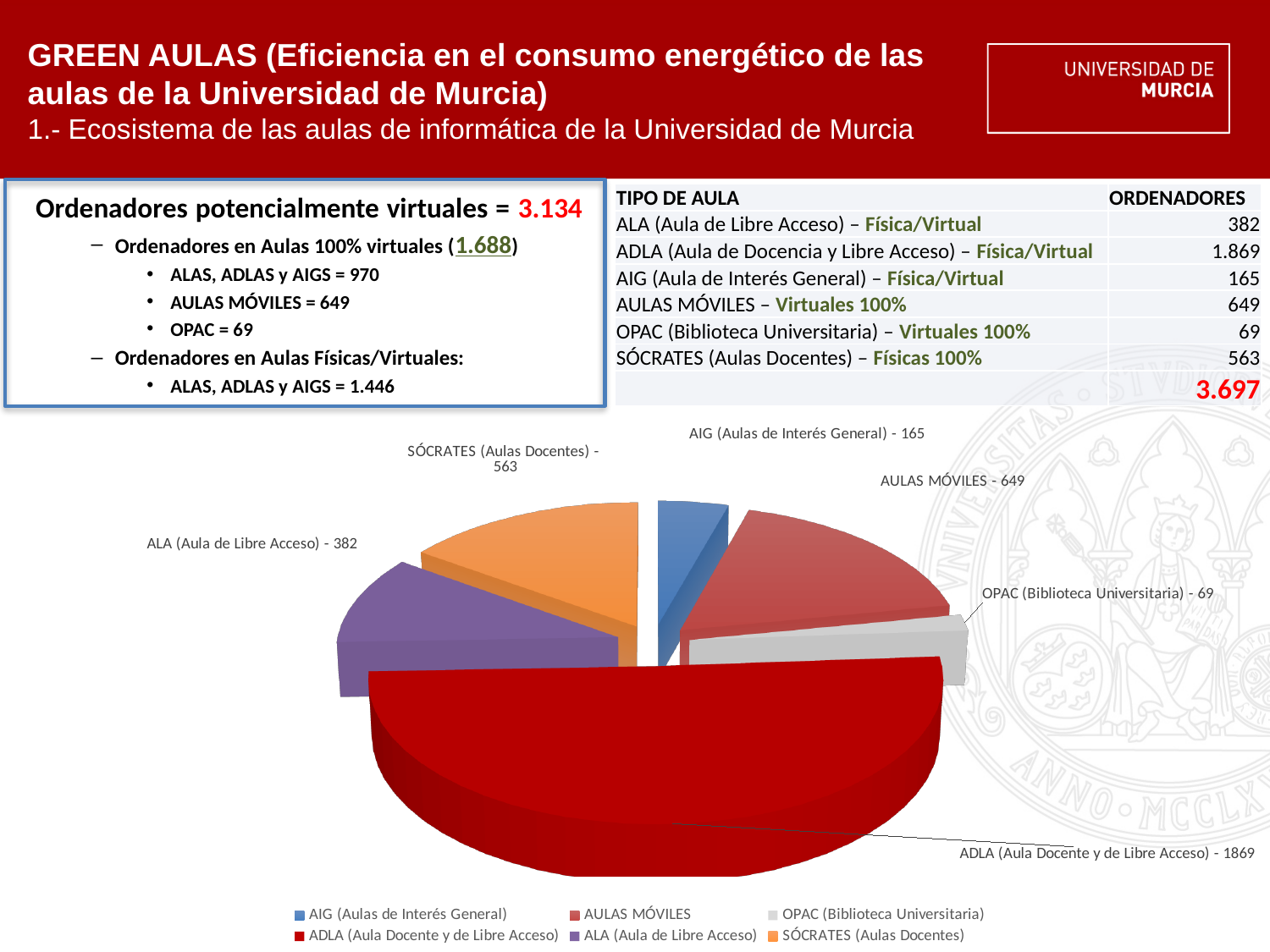
In the pie chart, what is the value for ALA (Aula de Libre Acceso)? 382 Which category has the smallest slice in the pie chart? OPAC (Biblioteca Universitaria) What colour is the ADLA (Aula Docente y de Libre Acceso) slice in the pie chart? red In the pie chart, what is the value for SÓCRATES (Aulas Docentes)? 563 In the pie chart, which is larger: ALA (Aula de Libre Acceso) or AIG (Aulas de Interés General)? ALA (Aula de Libre Acceso) In the pie chart, what is the value for OPAC (Biblioteca Universitaria)? 69 In the pie chart, what is the value for ADLA (Aula Docente y de Libre Acceso)? 1869 In the pie chart, what is the difference between the values for AULAS MÓVILES and SÓCRATES (Aulas Docentes)? 86 How many categories does the pie chart show? 6 In the pie chart, what is the value for AULAS MÓVILES? 649 What kind of chart is shown on the slide? pie chart Which category has the largest slice in the pie chart? ADLA (Aula Docente y de Libre Acceso)